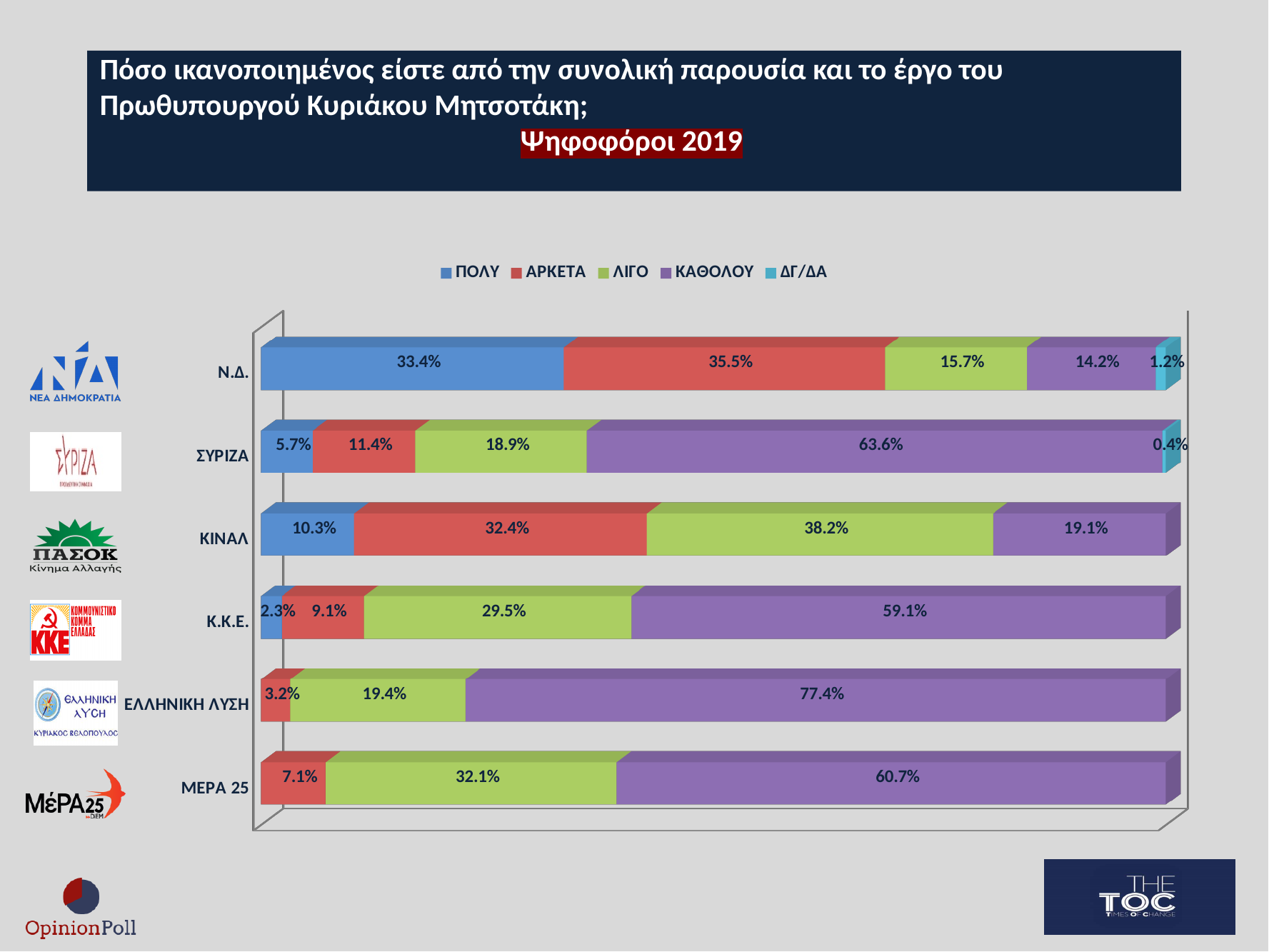
How many series does the legend list? 5 What is the ΚΑΘΟΛΟΥ value for ΕΛΛΗΝΙΚΗ ΛΥΣΗ? 77.4% What kind of chart is shown on the slide? Stacked bar chart Which colour represents ΚΑΘΟΛΟΥ in the legend? Purple What is the ΛΙΓΟ value for ΚΙΝΑΛ? 38.2% How many parties are shown on the chart? 6 What percentage of Ν.Δ. voters answered ΠΟΛΥ? 33.4% What is the difference between the ΑΡΚΕΤΑ value for Ν.Δ. and the ΑΡΚΕΤΑ value for ΚΙΝΑΛ? 3.1% What is the ΚΑΘΟΛΟΥ value for ΣΥΡΙΖΑ? 63.6% Which is larger: the ΚΑΘΟΛΟΥ value for Κ.Κ.Ε. or the ΚΑΘΟΛΟΥ value for ΜΕΡΑ 25? ΜΕΡΑ 25 Which party has the highest ΚΑΘΟΛΟΥ value? ΕΛΛΗΝΙΚΗ ΛΥΣΗ Which party has the lowest ΠΟΛΥ value among those with a ΠΟΛΥ label? Κ.Κ.Ε.